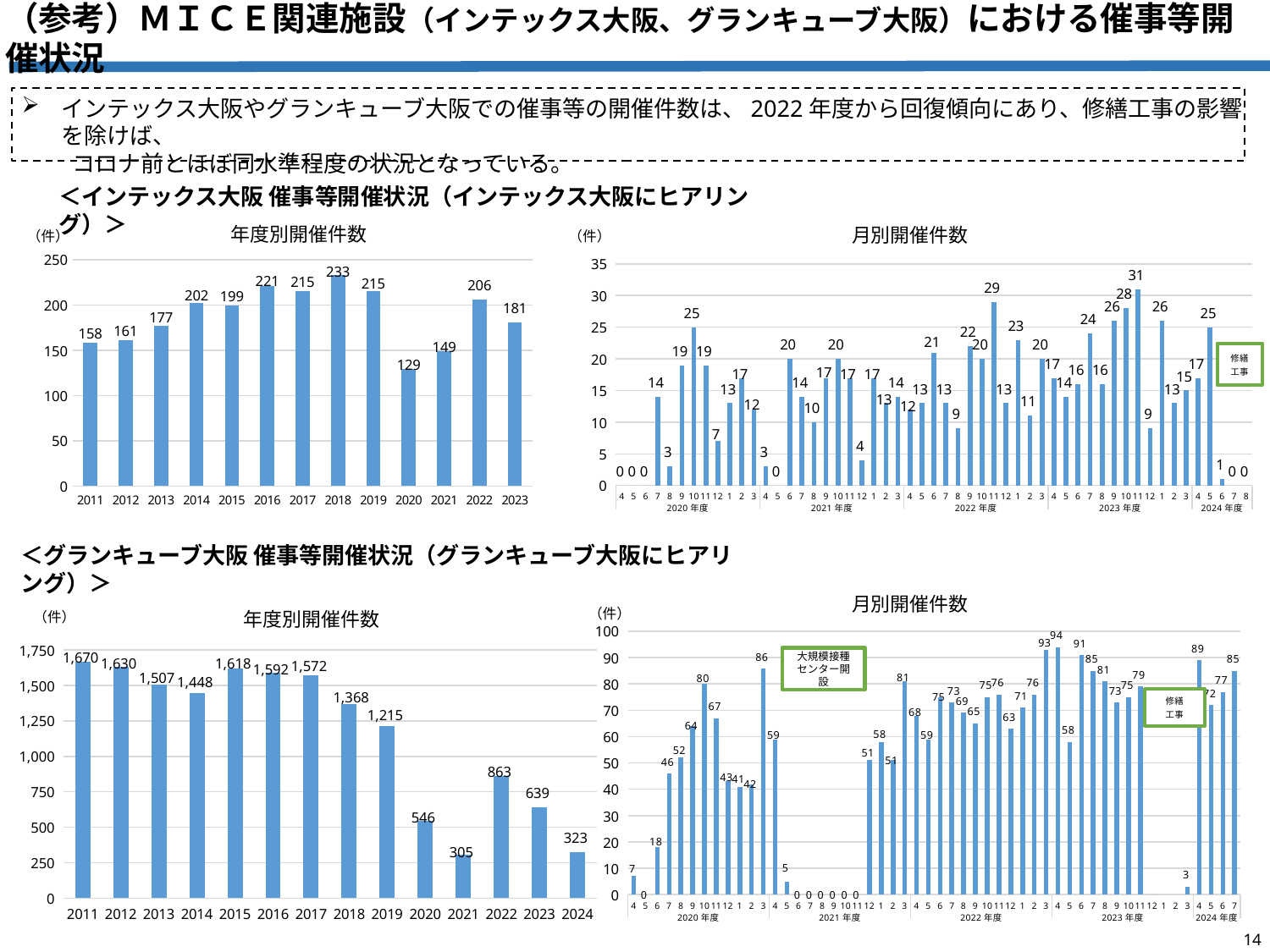
In the bottom-right chart (グランキューブ大阪 月別開催件数), what is the highest monthly value shown? 94 In the bottom-left chart (グランキューブ大阪 年度別開催件数), which year has the highest value? 2011 In the bottom-left chart (グランキューブ大阪 年度別開催件数), what kind of chart is it? Bar chart In the top-left chart (インテックス大阪 年度別開催件数), which year has the lowest value? 2020 In the top-left chart (インテックス大阪 年度別開催件数), how many years are plotted? 13 In the bottom-left chart (グランキューブ大阪 年度別開催件数), do the values generally rise or fall from 2015 to 2021? Fall In the bottom-left chart (グランキューブ大阪 年度別開催件数), which is larger, the value for 2022 or the value for 2023? 2022 In the bottom-left chart (グランキューブ大阪 年度別開催件数), what is the value for 2011? 1,670 In the top-right chart (インテックス大阪 月別開催件数), what is the highest monthly value shown? 31 In the top-left chart (インテックス大阪 年度別開催件数), what is the value for 2018? 233 In the bottom-left chart (グランキューブ大阪 年度別開催件数), what is the difference between the 2019 value and the 2020 value? 669 In the top-left chart (インテックス大阪 年度別開催件数), what is the difference between the 2022 value and the 2023 value? 25